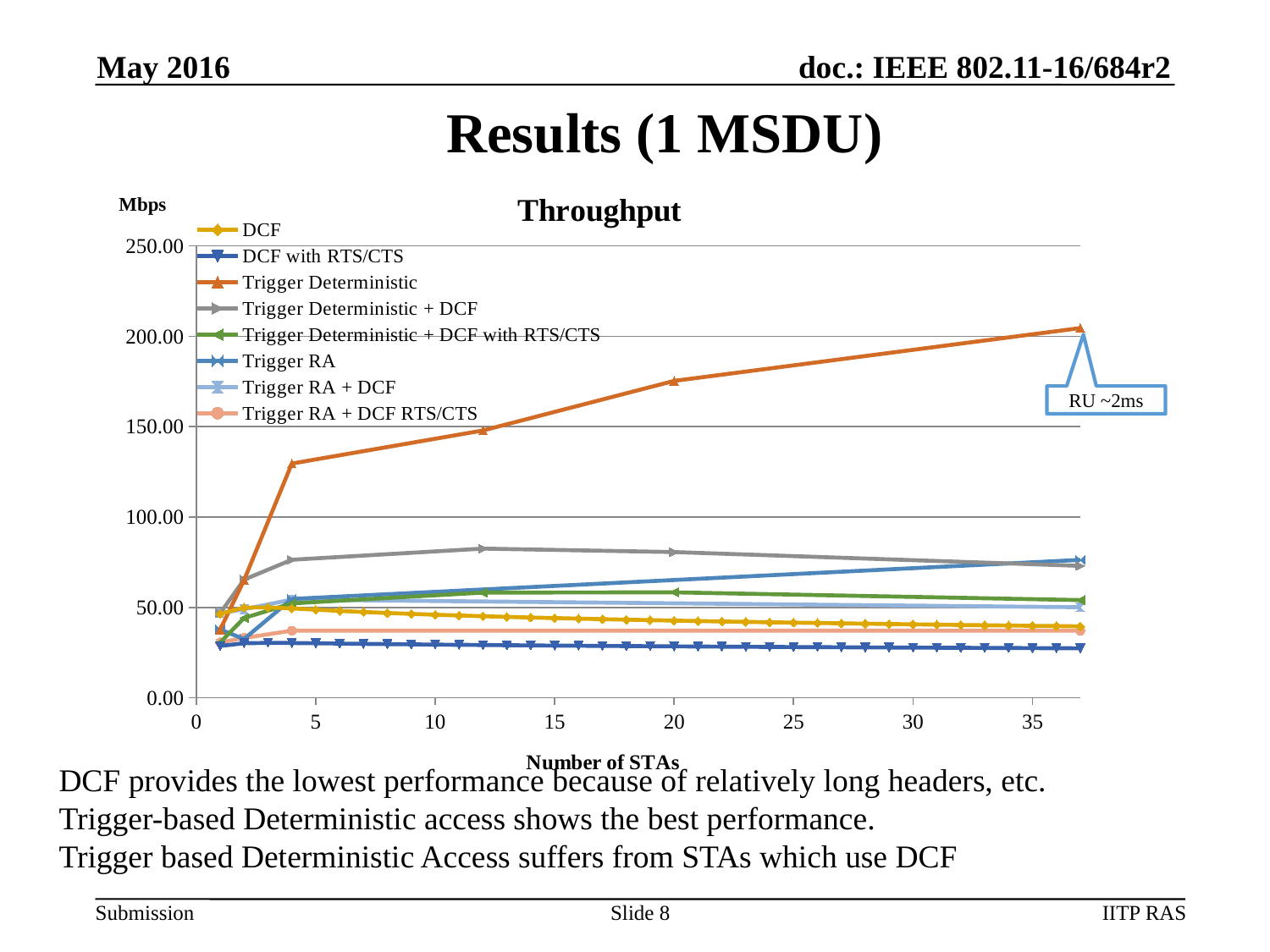
Is the throughput of DCF with RTS/CTS at 35 STAs greater or less than 50? less Is the throughput of Trigger Deterministic at 20 STAs greater or less than 150? greater At the largest number of STAs shown, which is larger: Trigger Deterministic or Trigger Deterministic + DCF? Trigger Deterministic What is the label of the x axis of the chart? Number of STAs Which series has the lowest throughput at the largest number of STAs shown? DCF with RTS/CTS Does the throughput of Trigger Deterministic rise or fall as the number of STAs increases? rise How many series does the legend of the Throughput chart list? 8 What kind of chart is shown on the slide? line chart What is the title of the chart? Throughput At 30 STAs, which is larger: Trigger RA or DCF? Trigger RA Is the throughput of Trigger Deterministic + DCF at 12 STAs greater or less than 100? less Which series has the highest throughput at the largest number of STAs shown? Trigger Deterministic